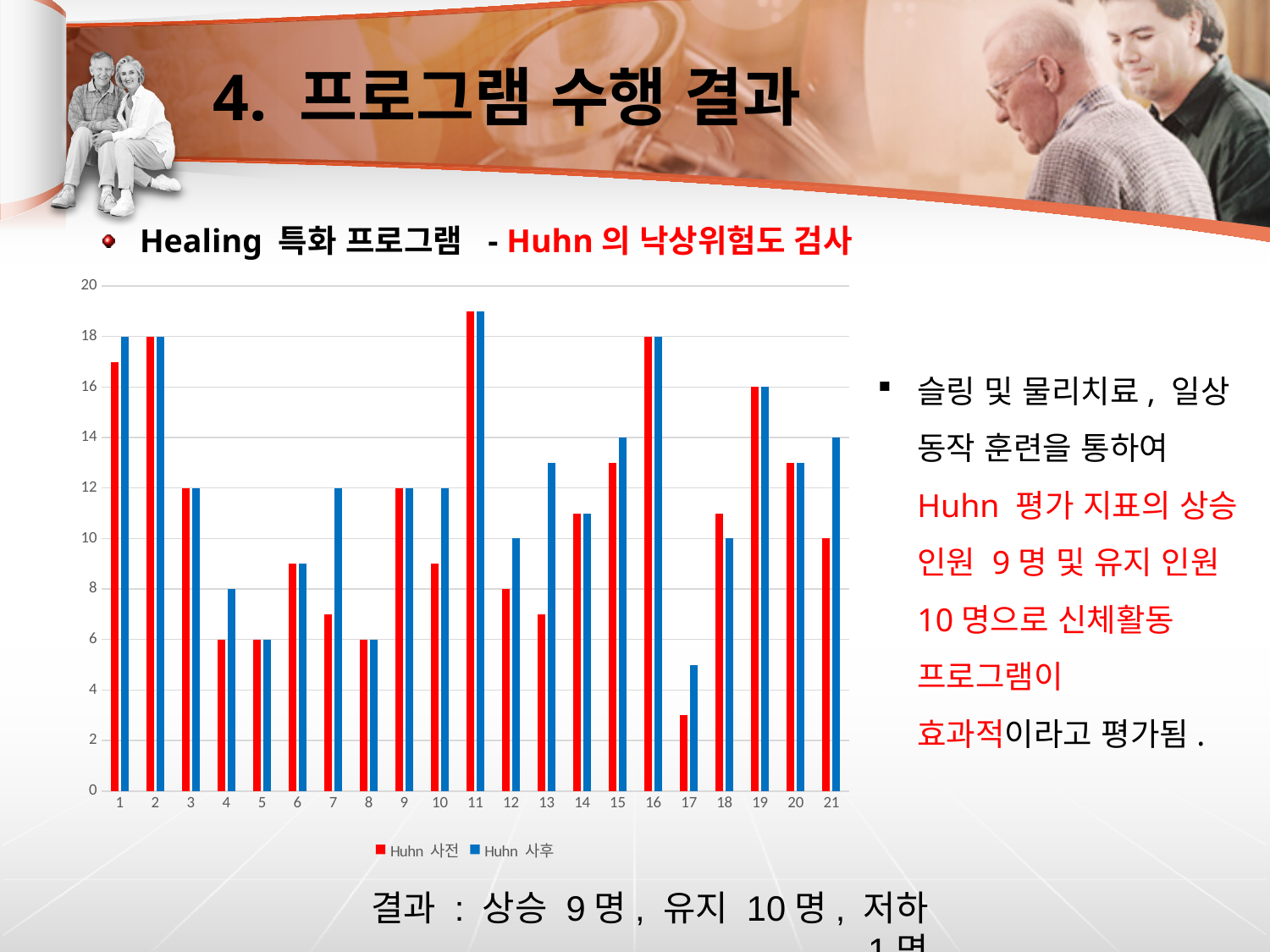
For category 13, which is larger, the Huhn 사전 value or the Huhn 사후 value? Huhn 사후 What type of chart is shown on the slide? bar chart What is the Huhn 사후 value for category 21? 14 Is the Huhn 사후 value for category 17 greater or less than 6? less Which category has the highest Huhn 사전 value? 11 How many categories are shown on the x axis of the chart? 21 How many series does the chart legend list? 2 What is the Huhn 사전 value for category 2? 18 Which category has the lowest Huhn 사전 value? 17 What is the Huhn 사전 value for category 19? 16 What is the difference between the Huhn 사후 and Huhn 사전 values for category 4? 2 What is the Huhn 사후 value for category 7? 12